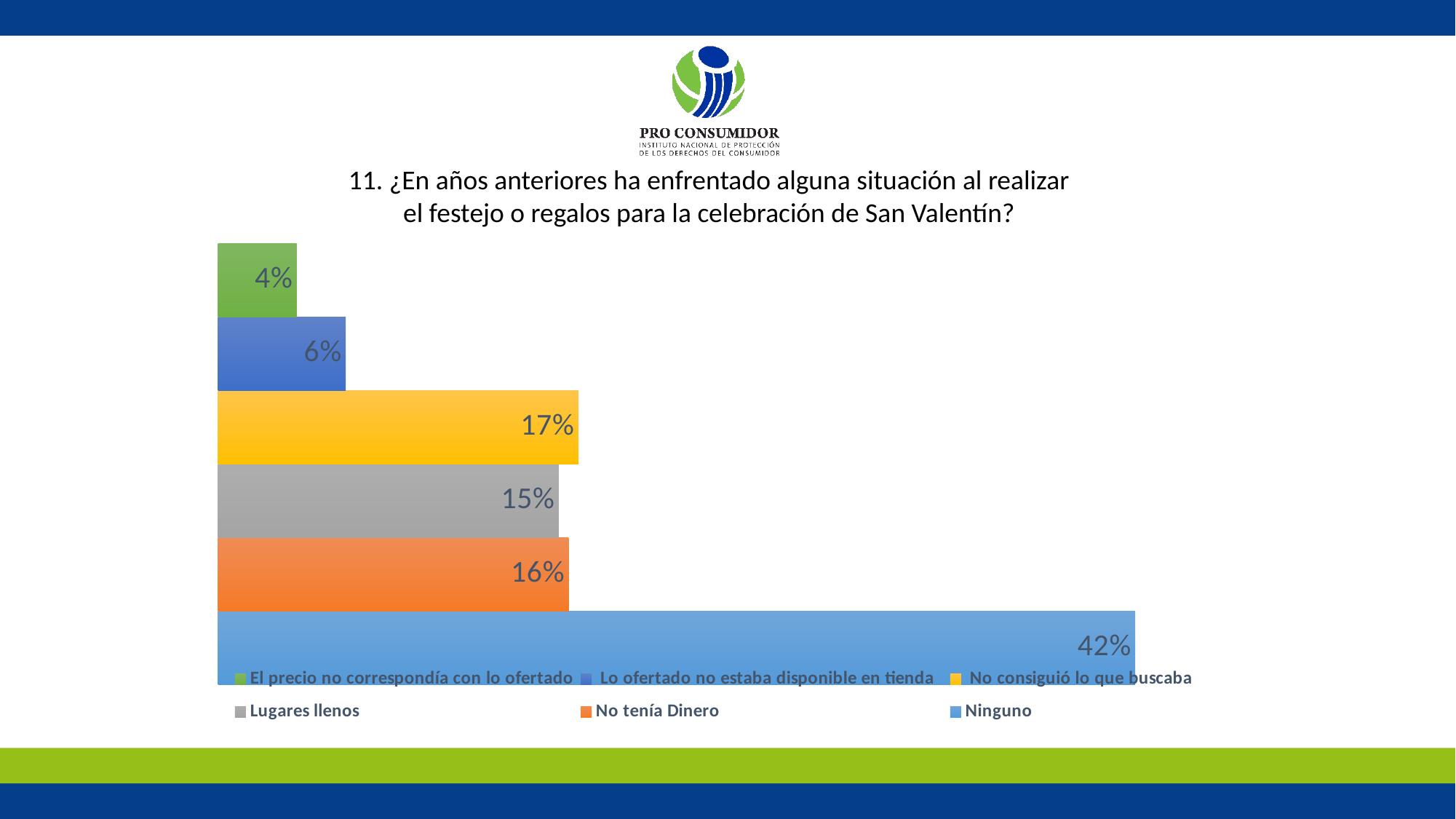
How many categories does the legend list? 6 What percentage is shown for "Ninguno"? 42% What percentage is shown for "No tenía Dinero"? 16% Which category has the lowest percentage? El precio no correspondía con lo ofertado Which category has the highest percentage? Ninguno Which is larger, the value for "Lo ofertado no estaba disponible en tienda" or the value for "Lugares llenos"? Lugares llenos What percentage is shown for "Lugares llenos"? 15% What is the difference between the percentages for "Ninguno" and "No consiguió lo que buscaba"? 25% What kind of chart is shown on the slide? Bar chart What percentage is shown for "No consiguió lo que buscaba"? 17% What percentage is shown for "El precio no correspondía con lo ofertado"? 4% What colour is the bar for "No consiguió lo que buscaba"? Yellow